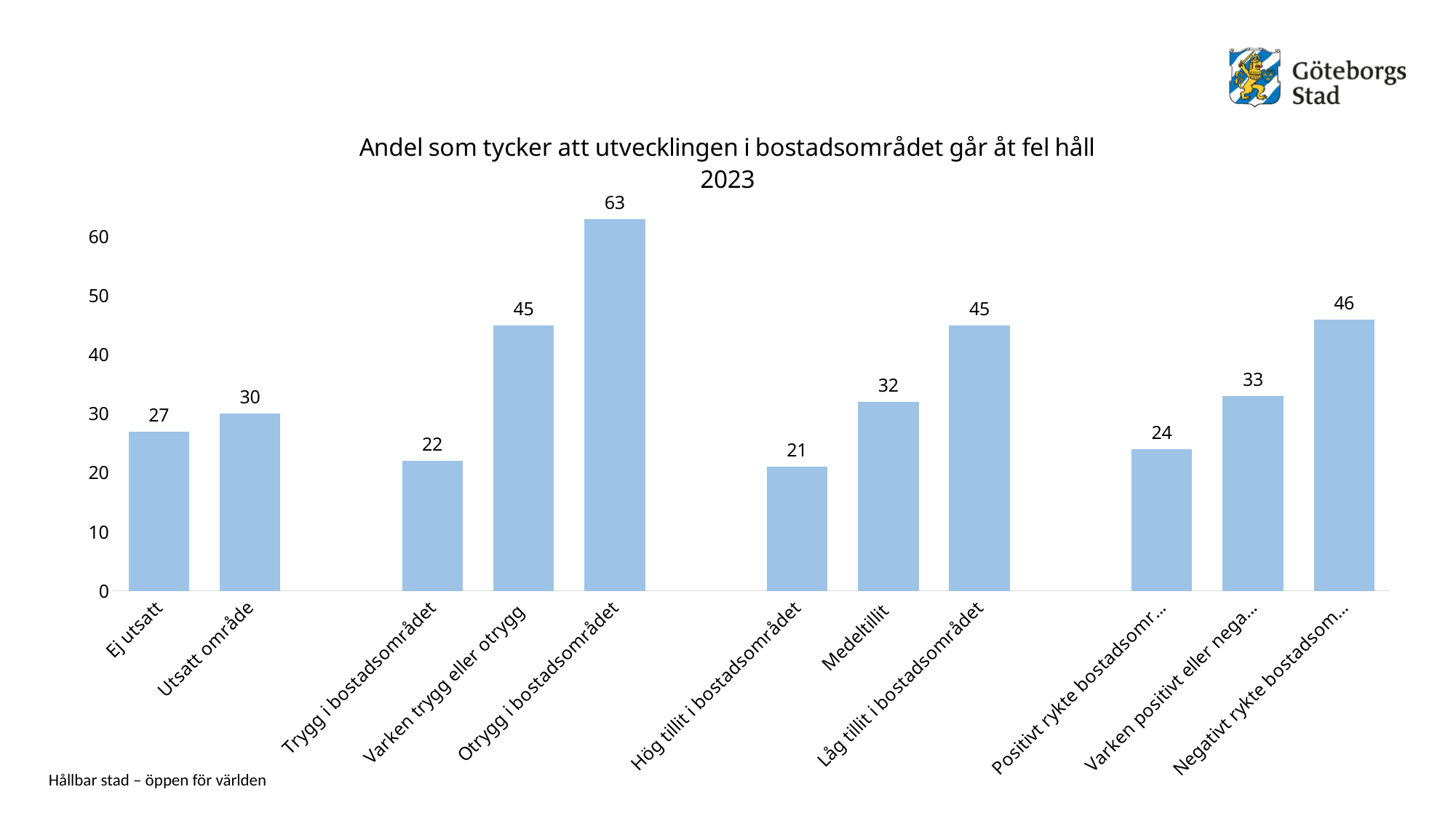
Which category has the highest value? Otrygg i bostadsområdet What is the value for Ej utsatt? 27 What year is shown in the chart title? 2023 What is the value for Hög tillit i bostadsområdet? 21 Which category has the lowest value? Hög tillit i bostadsområdet Which is larger, the value for Låg tillit i bostadsområdet or the value for Medeltillit? Låg tillit i bostadsområdet What is the value for Medeltillit? 32 What is the value for Otrygg i bostadsområdet? 63 What is the difference between the values for Utsatt område and Ej utsatt? 3 What is the difference between the values for Otrygg i bostadsområdet and Trygg i bostadsområdet? 41 How many bars are shown in the chart? 11 What kind of chart is shown on the slide? Bar chart